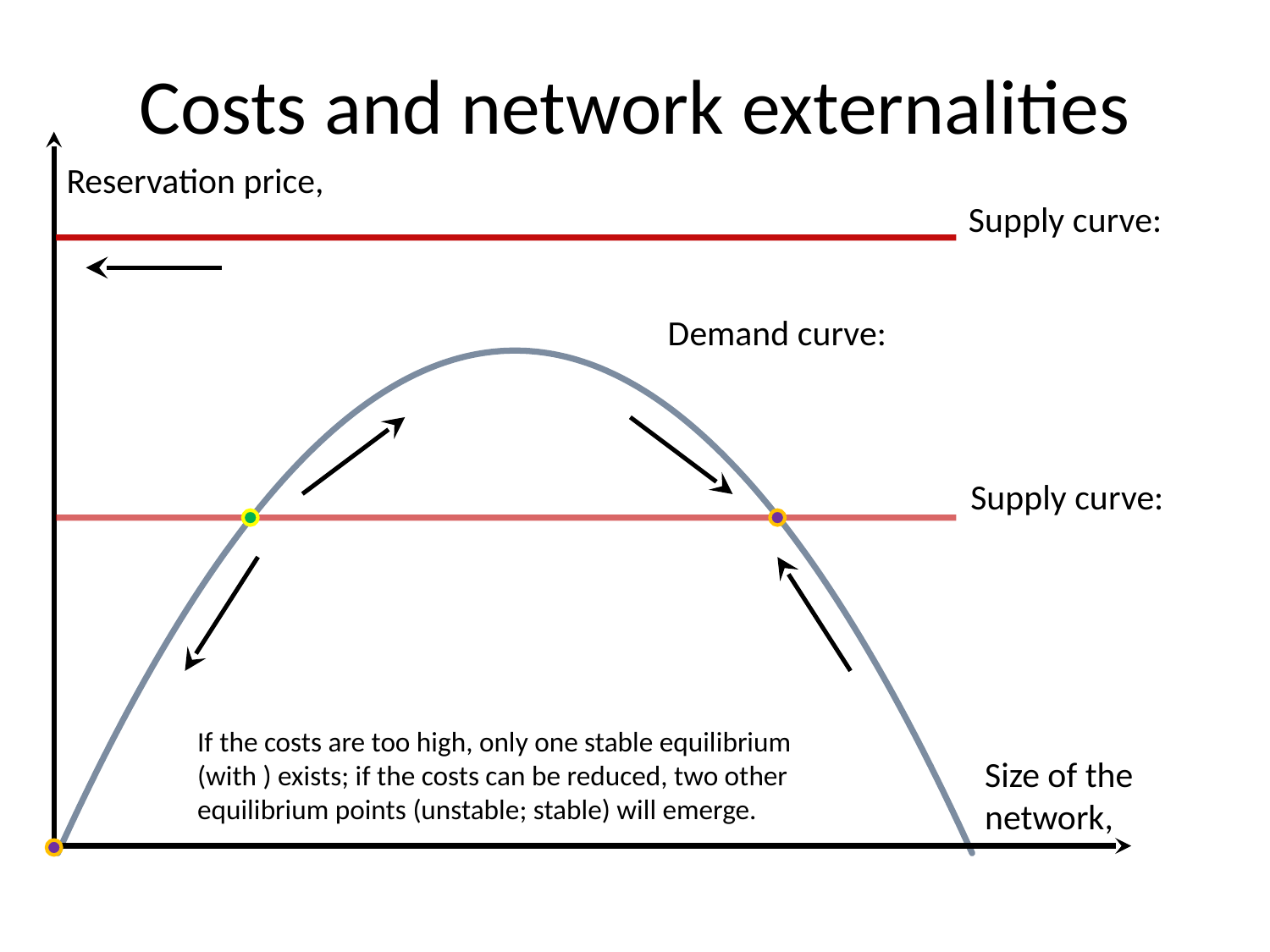
Does the demand curve rise or fall along the x axis after its peak? fall How many equilibrium points lie on the lower supply curve? 2 What is the label on the horizontal axis of the chart? Size of the network, How many supply curves (horizontal lines) are drawn on the chart? 2 How many equilibrium points are marked with circles on the chart? 3 Does the upper supply curve intersect the demand curve? No Does the demand curve rise or fall as the size of the network increases from the origin to its peak? rise What is the title of the chart on the slide? Costs and network externalities